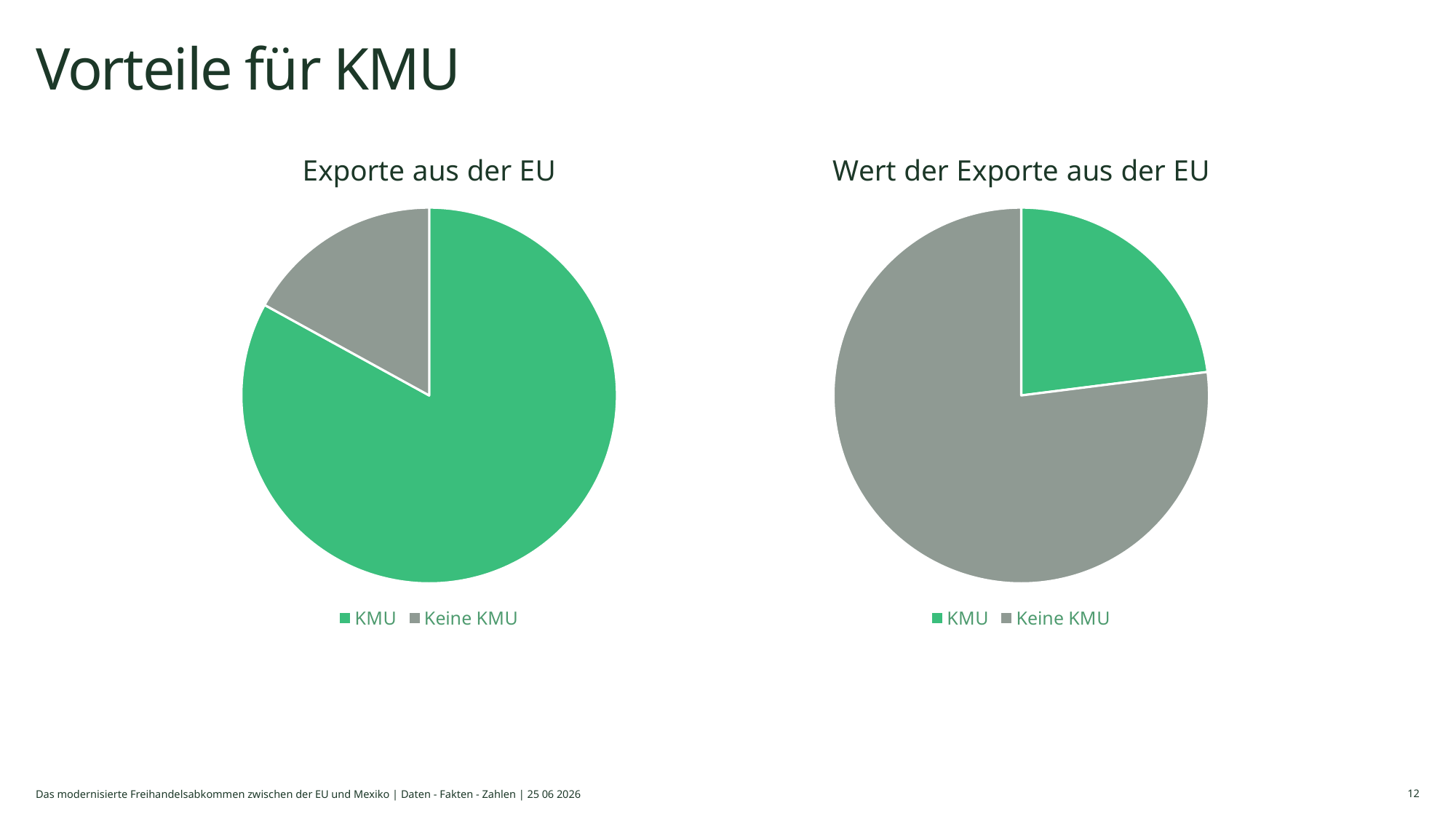
What kind of chart is the "Exporte aus der EU" chart? pie chart In the "Exporte aus der EU" chart, which slice is larger, KMU or Keine KMU? KMU In the "Wert der Exporte aus der EU" chart, which category has the largest slice? Keine KMU What kind of chart is the "Wert der Exporte aus der EU" chart? pie chart How many entries does the legend of the "Wert der Exporte aus der EU" chart list? 2 In the "Exporte aus der EU" chart, which category has the smallest slice? Keine KMU In the "Wert der Exporte aus der EU" chart, which category has the smallest slice? KMU In the "Exporte aus der EU" chart, what colour is the KMU slice? green In the "Exporte aus der EU" chart, which category has the largest slice? KMU In the "Wert der Exporte aus der EU" chart, which slice is larger, KMU or Keine KMU? Keine KMU How many slices does the "Exporte aus der EU" pie chart have? 2 What is the title of the pie chart on the right side of the slide? Wert der Exporte aus der EU